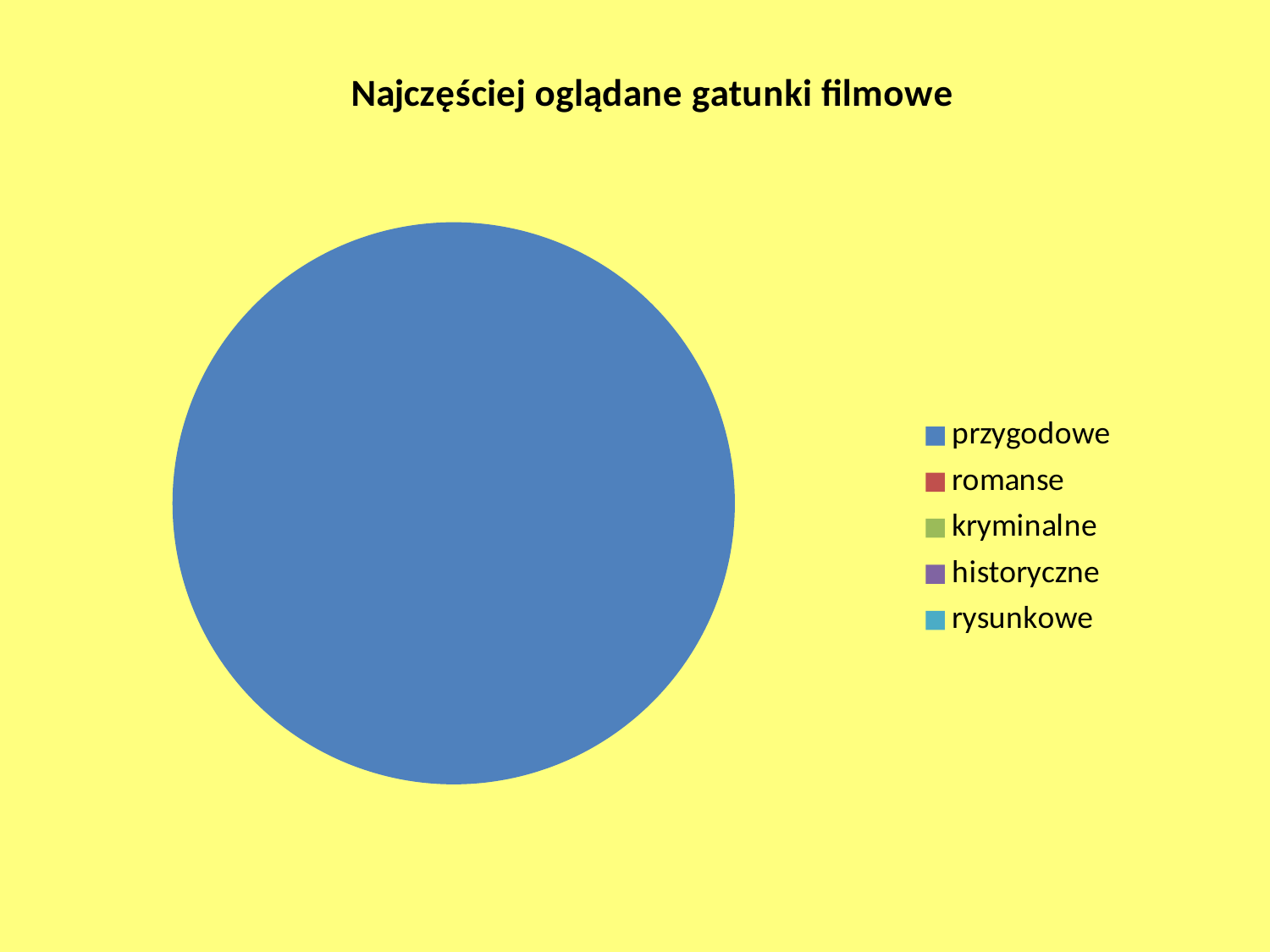
What is the title of the chart? Najczęściej oglądane gatunki filmowe Which category is larger in the pie, przygodowe or rysunkowe? przygodowe How many categories does the legend list? 5 Which category is shown in blue in the legend? przygodowe Which category takes up the largest share of the pie? przygodowe What kind of chart is shown on the slide? pie chart Which category is larger in the pie, przygodowe or romanse? przygodowe